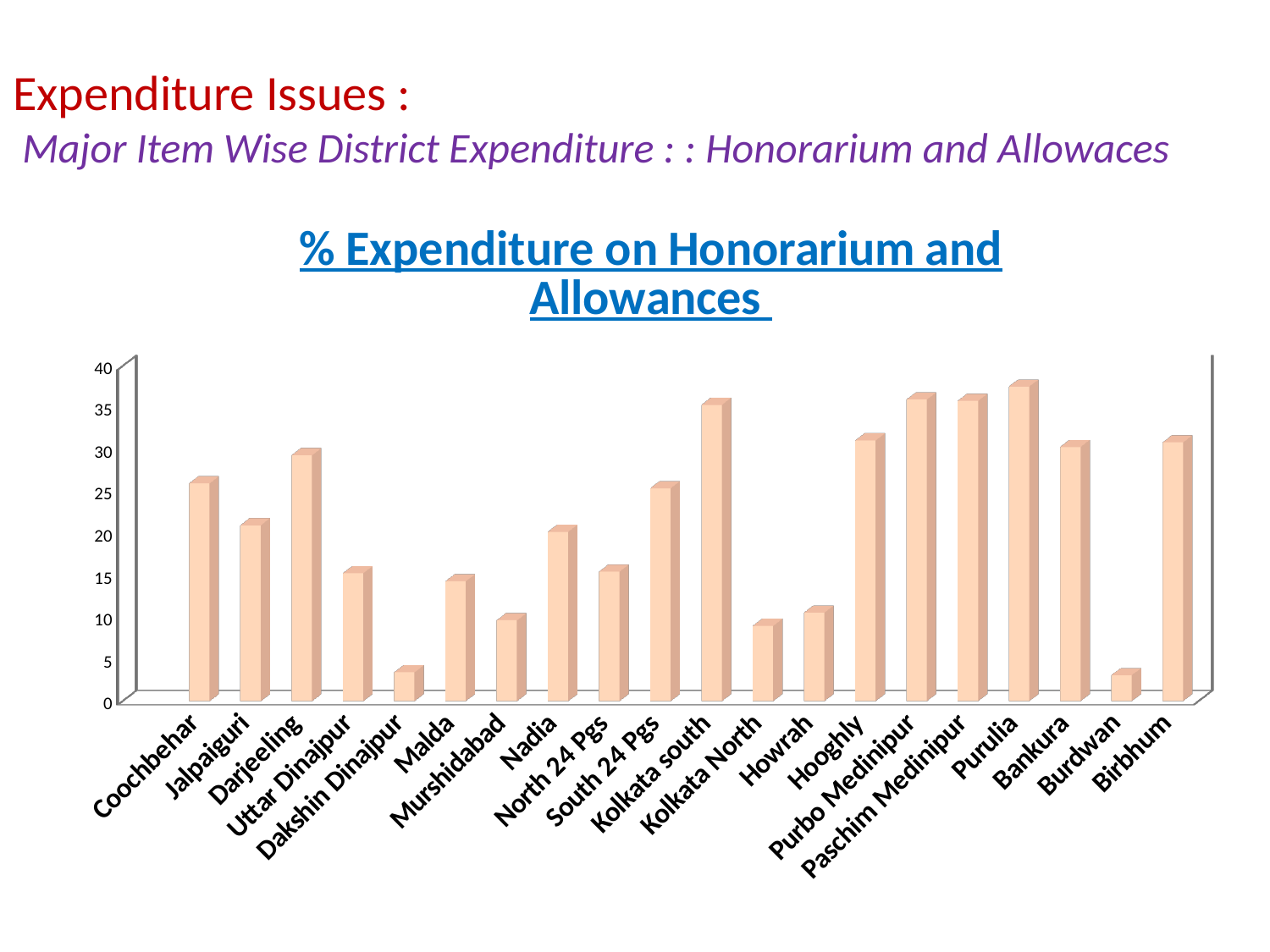
Is the value for Dakshin Dinajpur greater or less than 5? less How many districts are shown on the x axis of the chart? 20 Is the value for Nadia greater or less than 25? less Is the value for Murshidabad greater or less than 15? less Which district has the highest % expenditure on honorarium and allowances? Purulia Which has a higher value, Darjeeling or Jalpaiguri? Darjeeling Which has a higher value, Kolkata south or Kolkata North? Kolkata south What kind of chart is shown on the slide? bar chart Which has a higher value, Burdwan or Birbhum? Birbhum What is the title of the chart? % Expenditure on Honorarium and Allowances